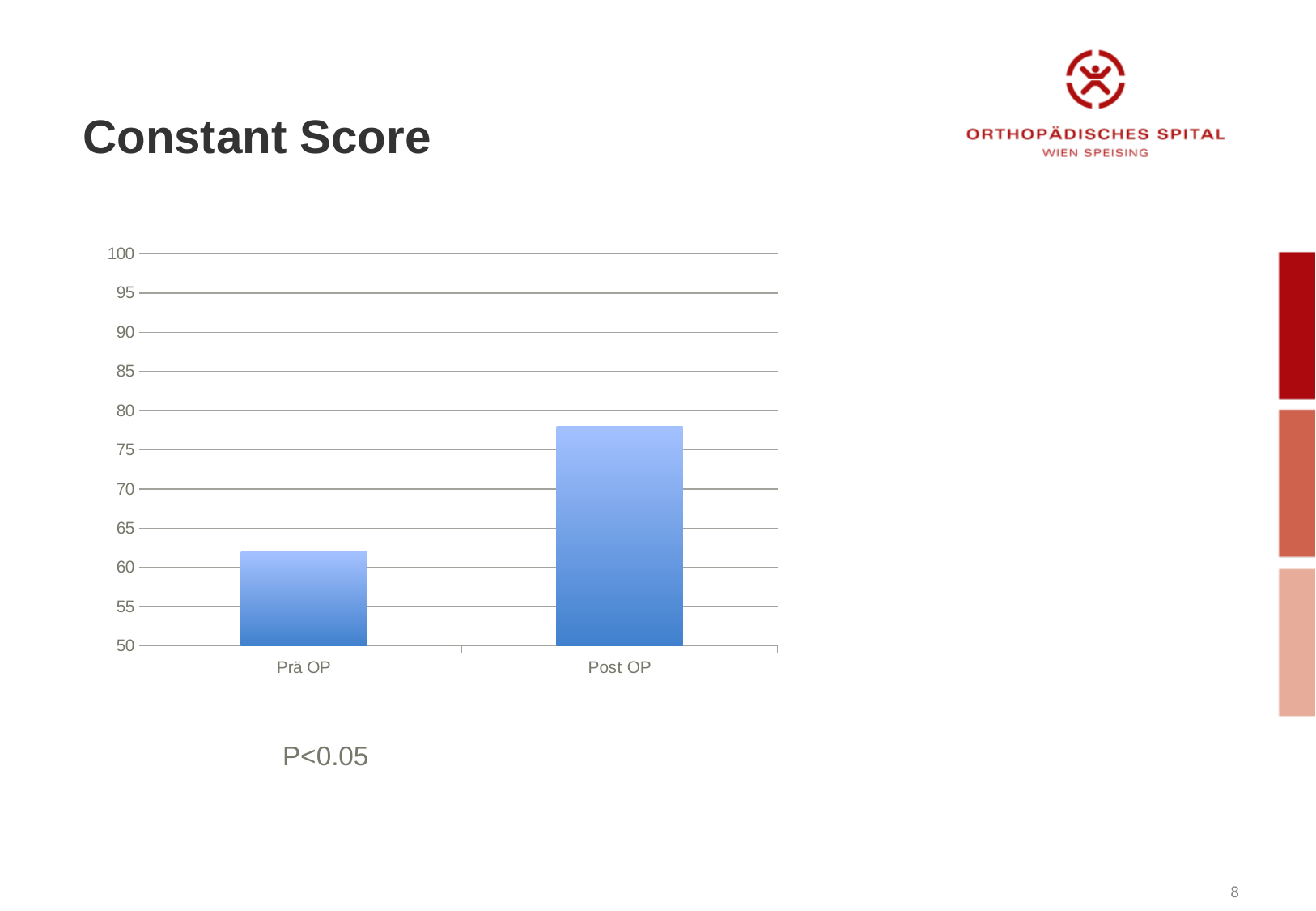
Which category has the lowest value? Prä OP Is the value for Post OP greater or less than 75? greater Which is larger, the value for Prä OP or the value for Post OP? Post OP Do the values rise or fall from Prä OP to Post OP? rise Is the value for Prä OP greater or less than 60? greater How many categories are plotted on the chart? 2 Which category has the highest value? Post OP What is the lowest value shown on the vertical axis of the chart? 50 Is the value for Prä OP greater or less than 65? less What kind of chart is shown on the slide? bar chart What is the title of the slide containing the chart? Constant Score